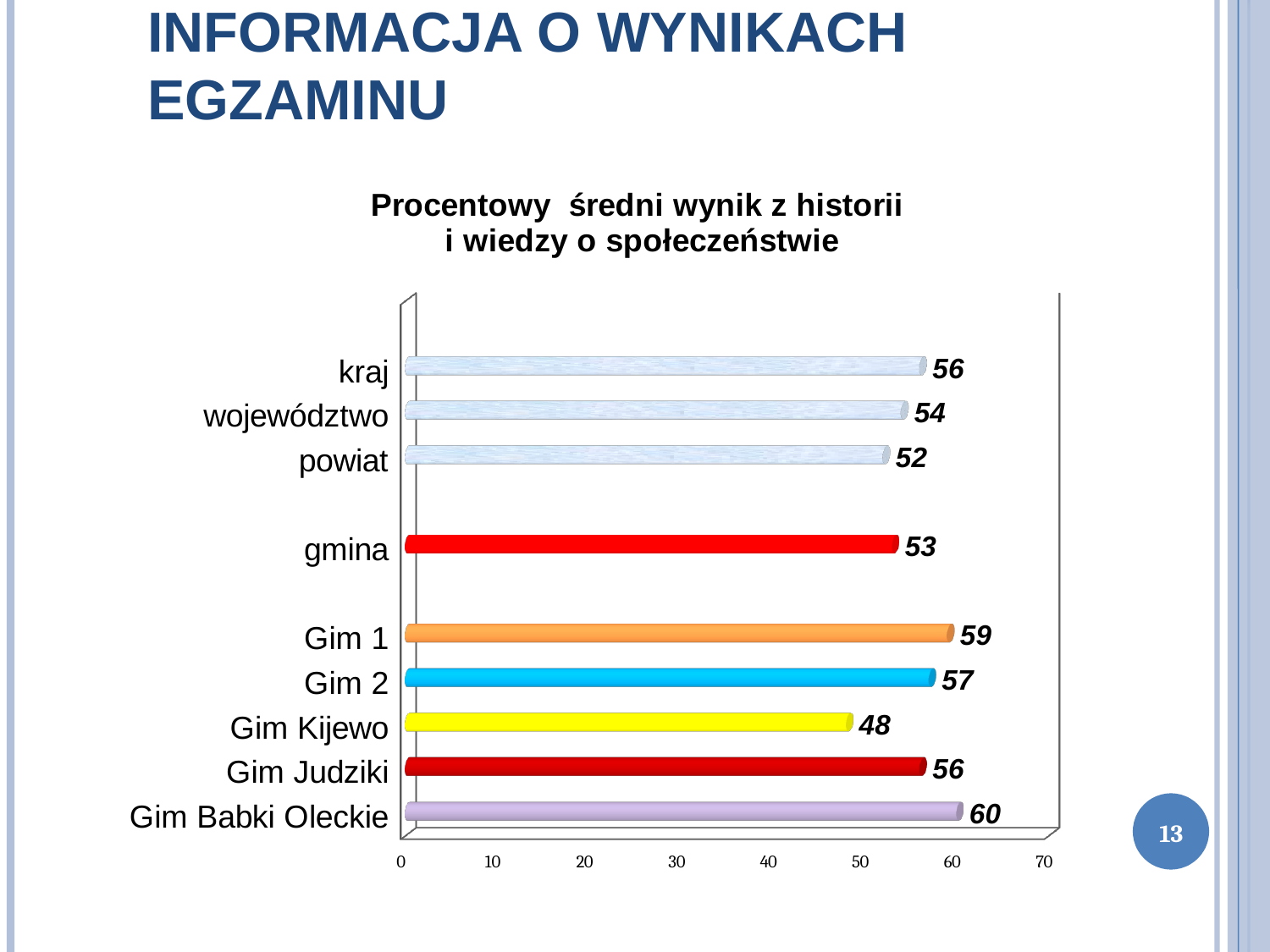
What is the value for gmina? 53 What is the difference between the values for kraj and powiat? 4 Which category has the lowest value? Gim Kijewo Which is larger, the value for Gim 2 or the value for gmina? Gim 2 What is the difference between the values for Gim 1 and Gim Kijewo? 11 What is the title of the chart? Procentowy średni wynik z historii i wiedzy o społeczeństwie Which category has the highest value? Gim Babki Oleckie What kind of chart is shown on the slide? bar chart How many categories are shown in the chart? 9 What is the value for województwo? 54 Is the value for Gim Judziki greater or less than 50? greater What is the value for Gim Kijewo? 48